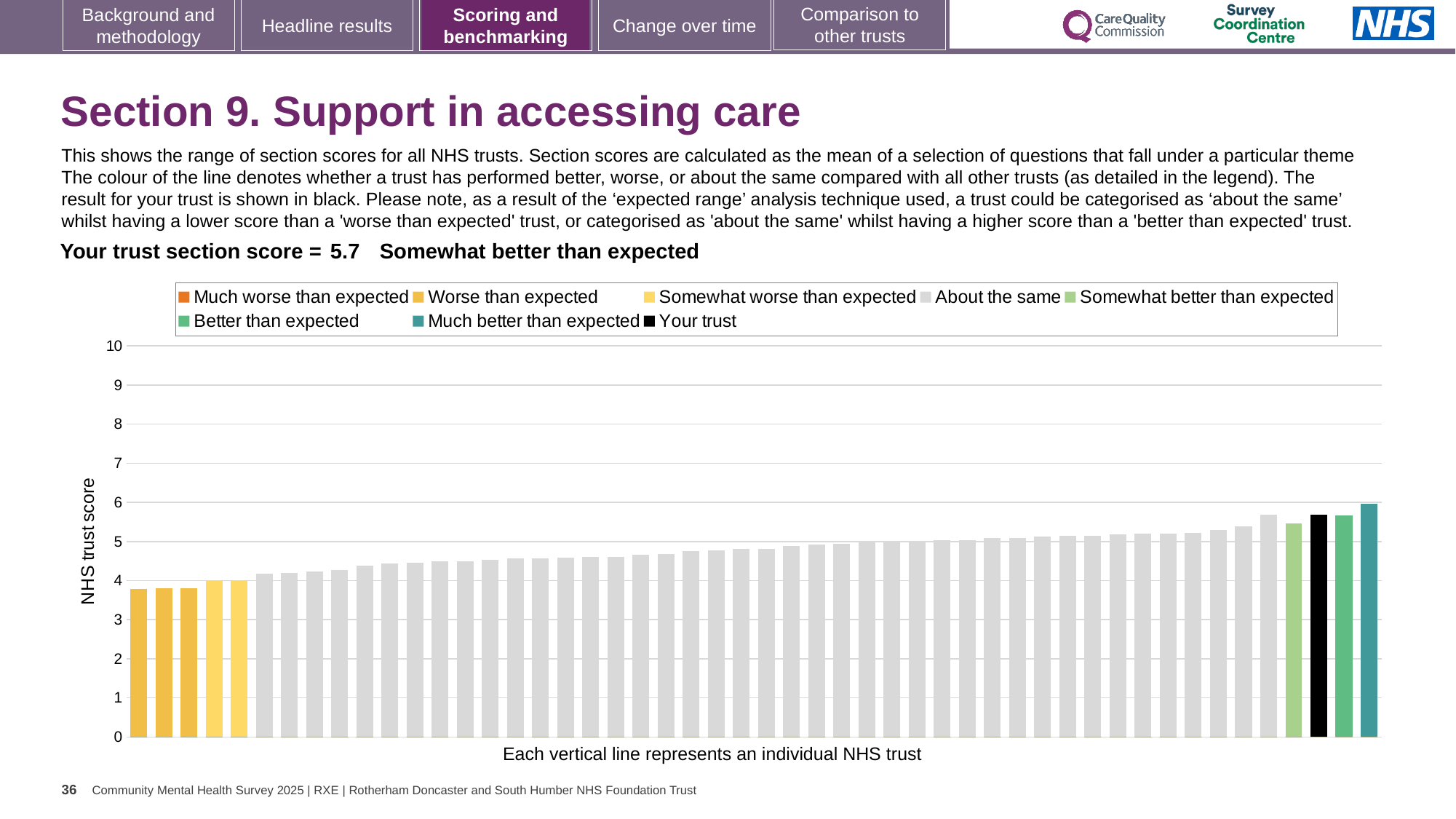
Which legend category does the lowest bar in the chart belong to? Worse than expected What is the section score for your trust shown on the slide? 5.7 Which legend category does the tallest bar in the chart belong to? Much better than expected What type of chart is shown on the slide? bar chart What is the label on the y axis of the chart? NHS trust score How many entries does the chart legend list? 8 Is the value for your trust's bar greater or less than 5? greater Is the value of the lowest bar in the chart greater or less than 4? less Is your trust's bar higher or lower than the tallest bar in the chart? lower Is the value of the tallest bar in the chart greater or less than 5? greater Do the bar values rise or fall from left to right along the x axis? rise How many bars are coloured as 'Worse than expected'? 3